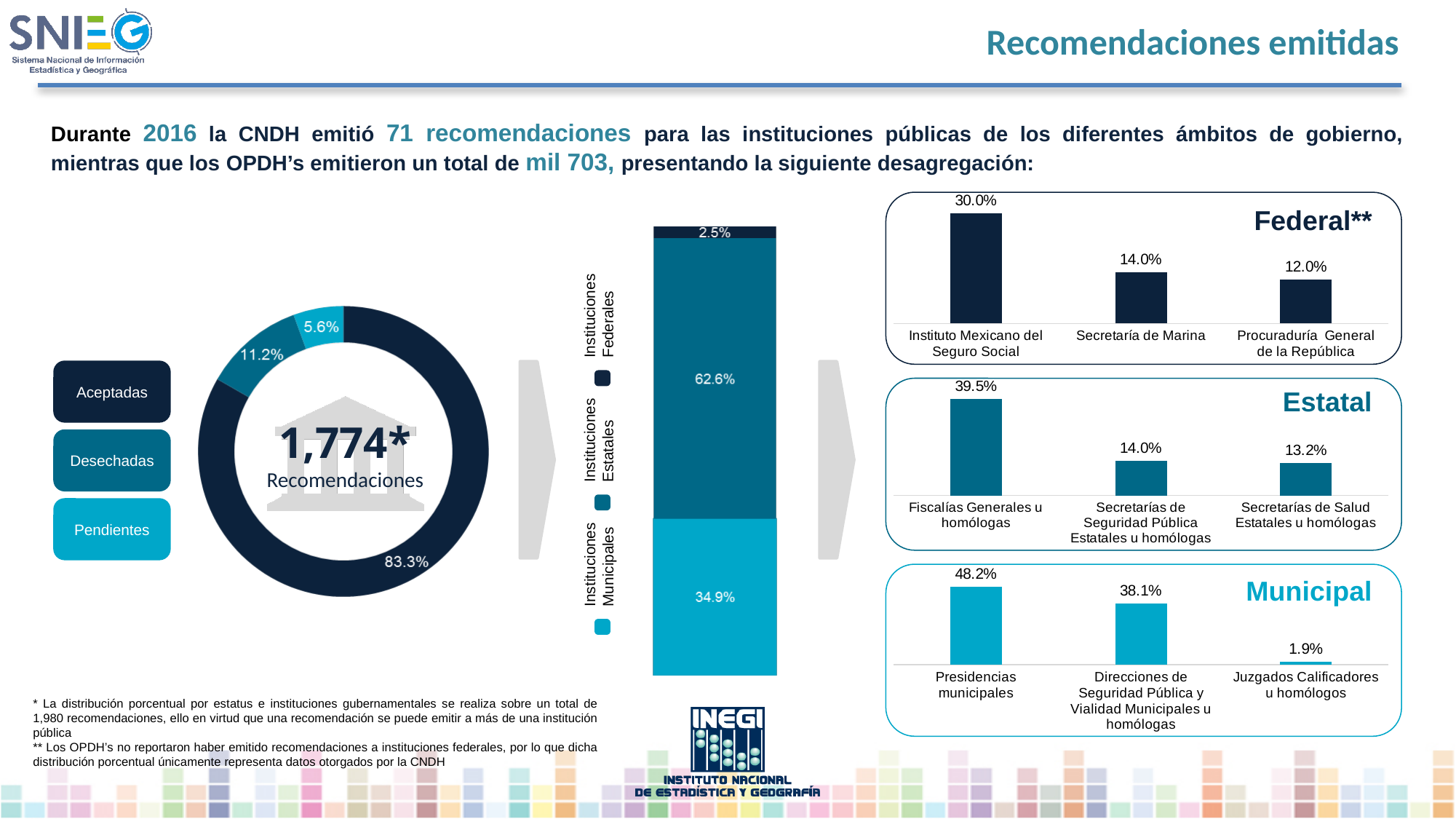
In the Municipal chart, what is the value for Juzgados Calificadores u homólogos? 1.9% In the Municipal chart, what is the difference between Presidencias municipales and Direcciones de Seguridad Pública y Vialidad Municipales u homólogas? 10.1% In the Federal** chart, what is the value for Secretaría de Marina? 14.0% In the donut chart on the left, what percentage of recommendations are Aceptadas? 83.3% In the stacked bar in the middle of the slide, what percentage corresponds to Instituciones Estatales? 62.6% In the Estatal chart, what is the value for Fiscalías Generales u homólogas? 39.5% In the Estatal chart, how many categories are shown? 3 In the donut chart on the left, what total number of recommendations is shown in the centre? 1,774* In the Federal** chart, which institution has the highest value? Instituto Mexicano del Seguro Social In the stacked bar in the middle of the slide, what is the difference between the Instituciones Estatales and Instituciones Municipales shares? 27.7% In the donut chart on the left, what percentage of recommendations are Pendientes? 5.6% In the stacked bar in the middle of the slide, which institution level has the smallest share? Instituciones Federales